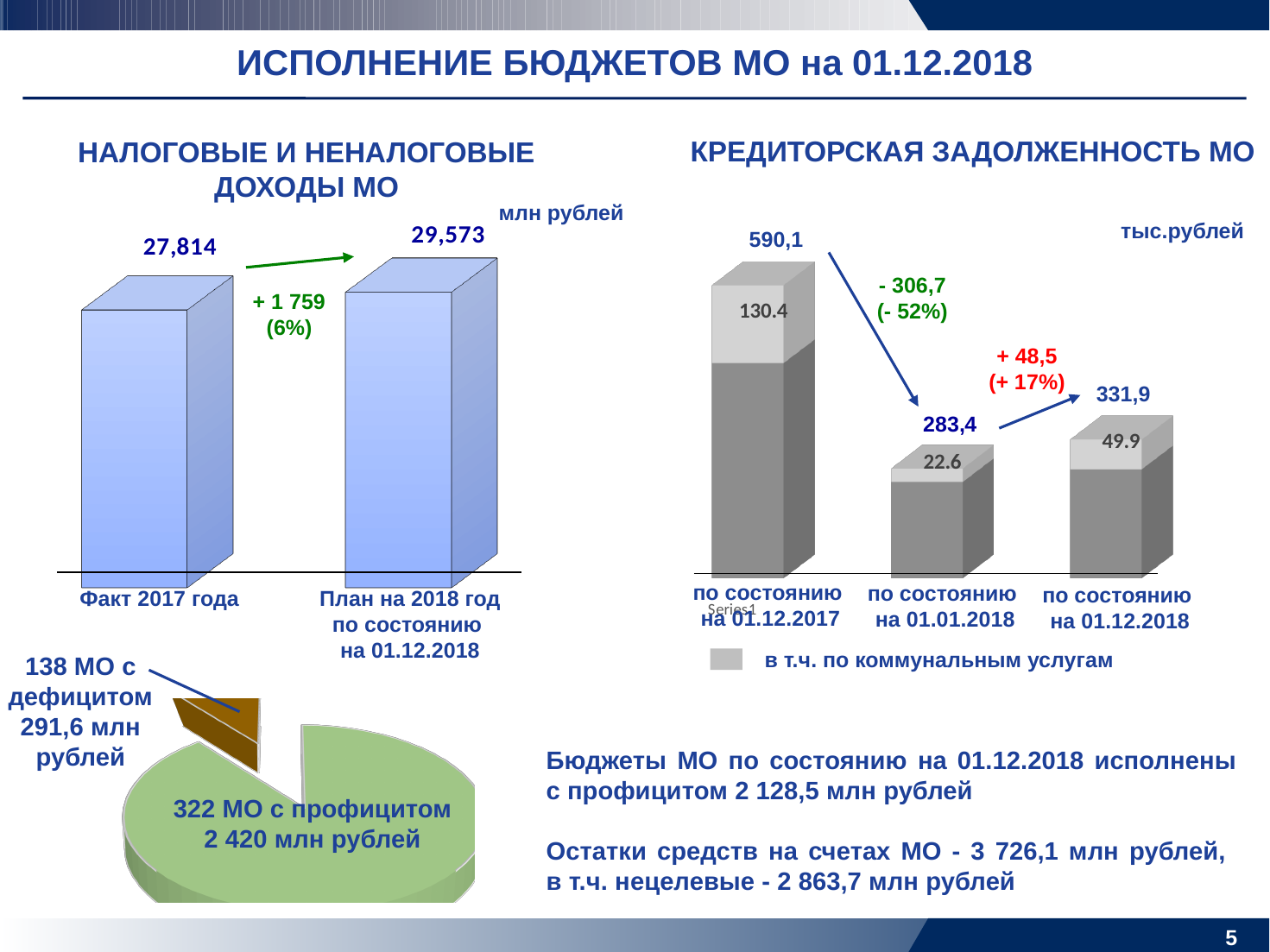
On the pie chart at the bottom left, how many МО have a surplus (профицит)? 322 On the chart 'КРЕДИТОРСКАЯ ЗАДОЛЖЕННОСТЬ МО', which date has the lowest total value? по состоянию на 01.01.2018 On the chart 'КРЕДИТОРСКАЯ ЗАДОЛЖЕННОСТЬ МО', what is the total value for 'по состоянию на 01.01.2018'? 283,4 On the chart 'НАЛОГОВЫЕ И НЕНАЛОГОВЫЕ ДОХОДЫ МО', which category has the higher value? План на 2018 год по состоянию на 01.12.2018 On the chart 'НАЛОГОВЫЕ И НЕНАЛОГОВЫЕ ДОХОДЫ МО', what is the value for 'Факт 2017 года'? 27,814 On the chart 'НАЛОГОВЫЕ И НЕНАЛОГОВЫЕ ДОХОДЫ МО', what unit is shown for the values? млн рублей On the chart 'НАЛОГОВЫЕ И НЕНАЛОГОВЫЕ ДОХОДЫ МО', what is the value for 'План на 2018 год по состоянию на 01.12.2018'? 29,573 On the chart 'КРЕДИТОРСКАЯ ЗАДОЛЖЕННОСТЬ МО', what is the total value for 'по состоянию на 01.12.2017'? 590,1 On the chart 'КРЕДИТОРСКАЯ ЗАДОЛЖЕННОСТЬ МО', what is the difference between the 'в т.ч. по коммунальным услугам' values for 01.12.2017 and 01.01.2018? 107.8 On the chart 'КРЕДИТОРСКАЯ ЗАДОЛЖЕННОСТЬ МО', how many bars are shown? 3 What kind of chart is shown at the bottom left of the slide? pie chart On the chart 'КРЕДИТОРСКАЯ ЗАДОЛЖЕННОСТЬ МО', what is the value 'в т.ч. по коммунальным услугам' for 'по состоянию на 01.12.2018'? 49.9